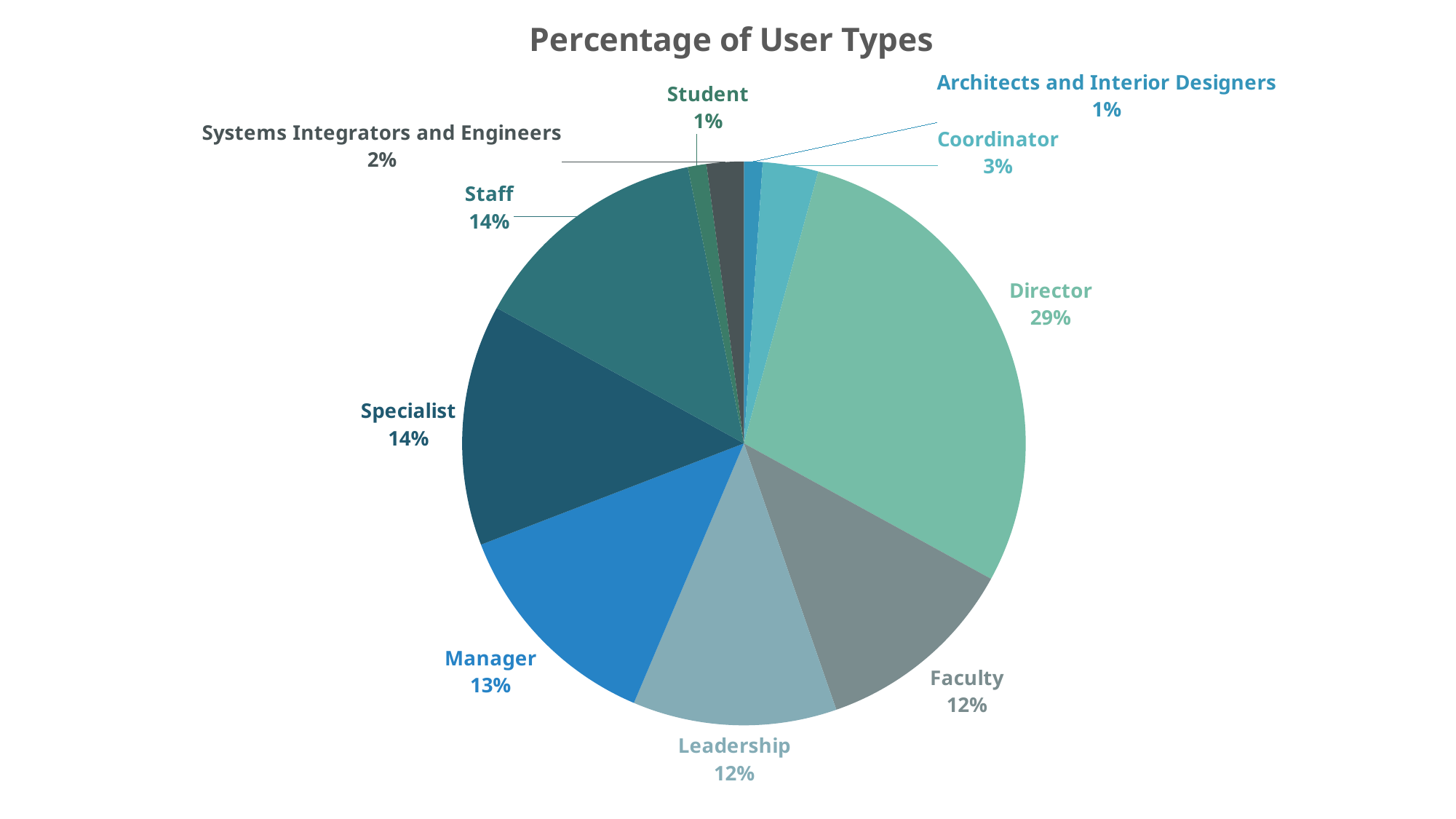
What percentage is shown for Coordinator? 3% What percentage of users are Directors? 29% What percentage is shown for Systems Integrators and Engineers? 2% Which is larger, the share for Staff or the share for Faculty? Staff Which user type has the largest share of the pie? Director What is the difference between the Specialist share and the Coordinator share? 11% How many user types are shown in the pie chart? 10 What is the difference in percentage between Director and Manager? 16% What type of chart is shown on the slide? pie chart What is the title of the chart? Percentage of User Types What share of the pie does the Manager slice represent? 13% What percentage of users are Students? 1%